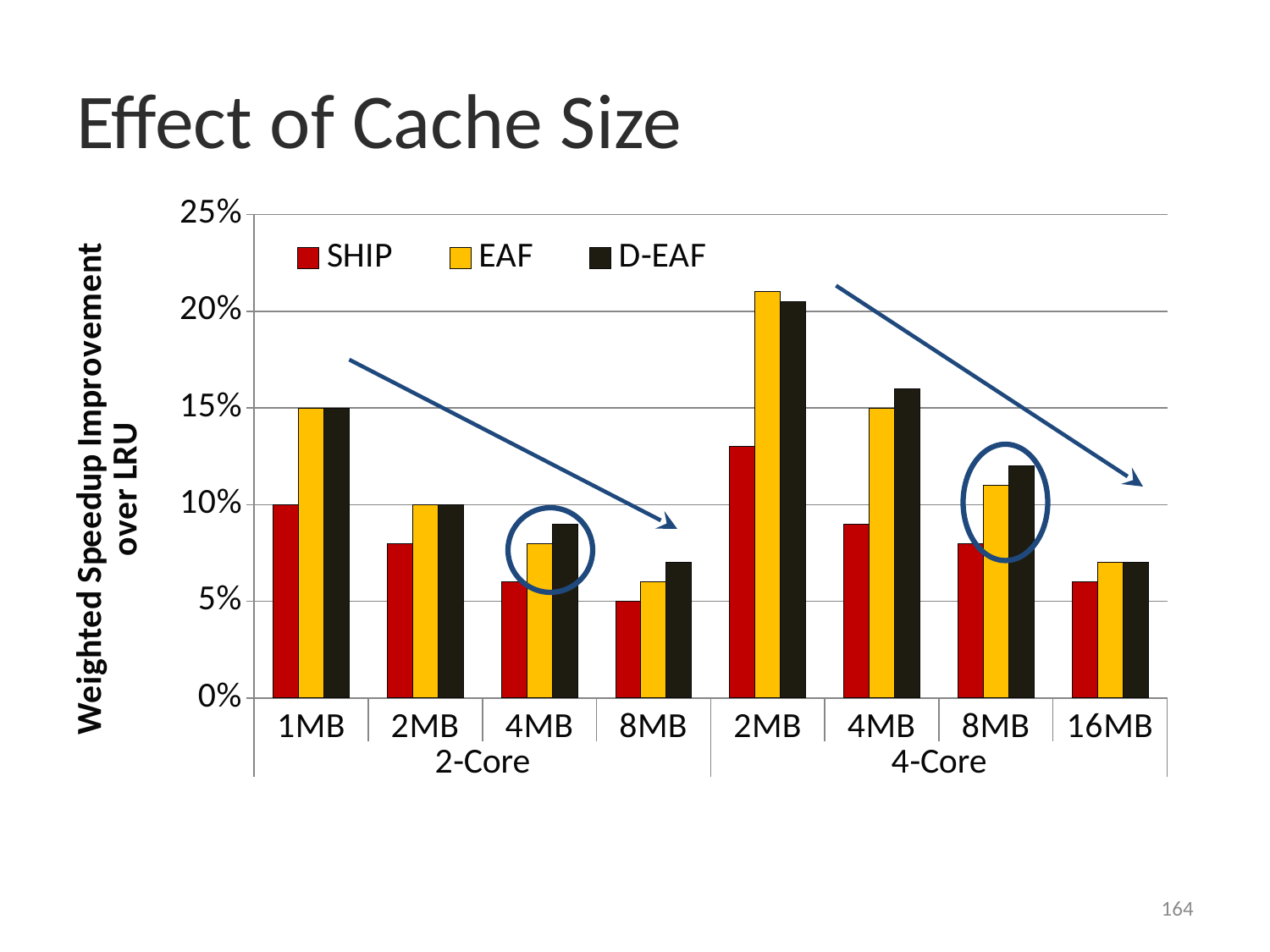
Is the value for EAF at 2MB in the 4-Core group greater or less than 20%? greater What is the weighted speedup improvement for EAF at 1MB in the 2-Core group? 15% What is the label of the y axis? Weighted Speedup Improvement over LRU Which cache size in the 2-Core group has the lowest SHIP value? 8MB How many series does the legend list? 3 Which cache size in the 4-Core group has the highest EAF value? 2MB Is the value for SHIP at 4MB in the 4-Core group greater or less than 10%? less How many cache-size categories are plotted along the x axis? 8 What is the weighted speedup improvement for SHIP at 1MB in the 2-Core group? 10% What kind of chart is shown on the slide? bar chart In the 4-Core group at 2MB, which is larger: the SHIP value or the EAF value? EAF What is the weighted speedup improvement for SHIP at 8MB in the 2-Core group? 5%